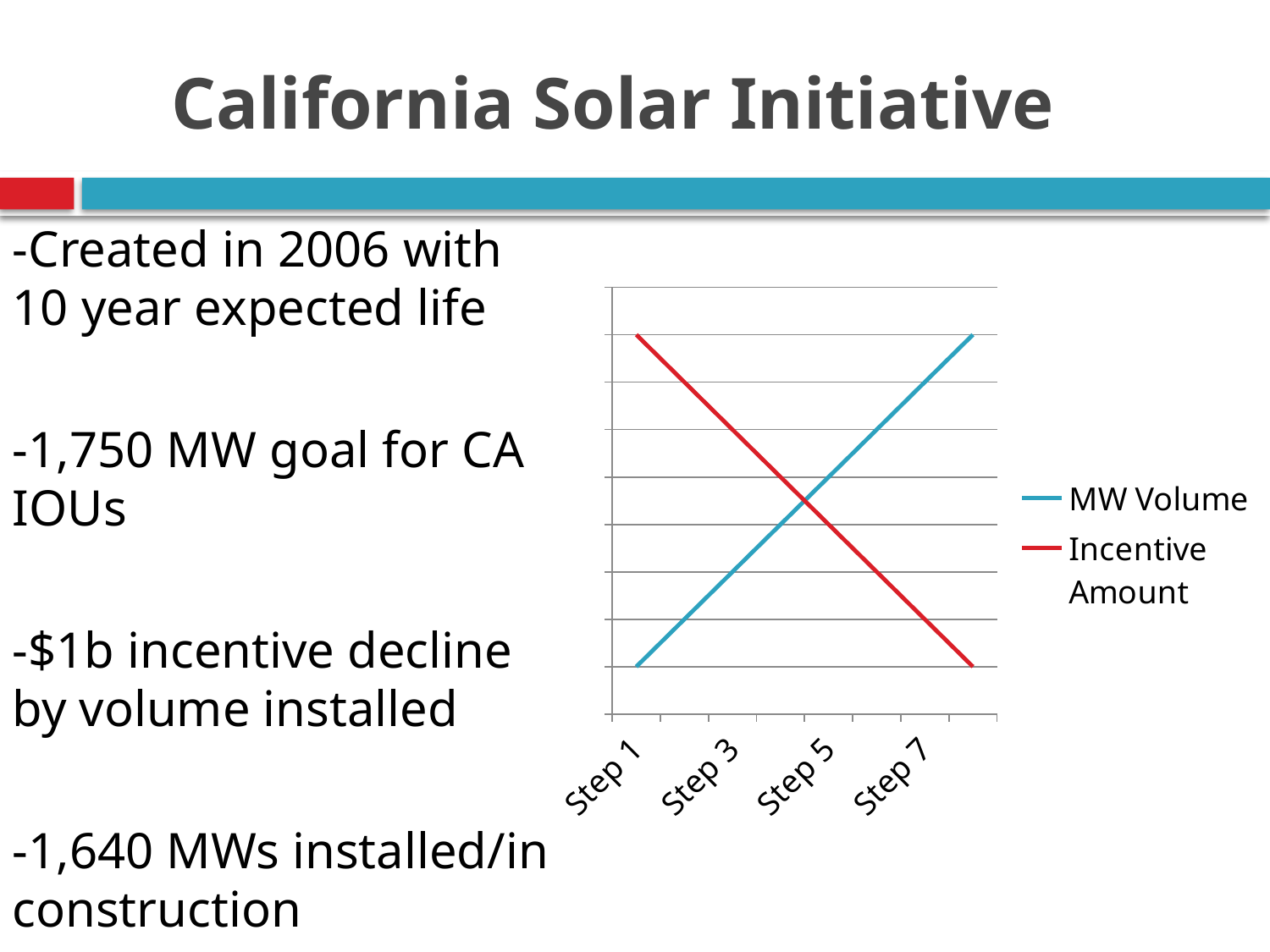
Which step label appears first on the x axis of the chart? Step 1 How many series does the chart's legend list? 2 How many step labels are printed along the x axis of the chart? 4 What are the two series named in the chart's legend? MW Volume and Incentive Amount What kind of chart is shown on the slide? Line chart At Step 1, which series has the higher value, MW Volume or Incentive Amount? Incentive Amount Which colour is used for the MW Volume line? Blue Does the Incentive Amount line rise or fall from Step 1 to Step 7? Fall At Step 7, which series has the higher value, MW Volume or Incentive Amount? MW Volume Does the MW Volume line rise or fall from Step 1 to Step 7? Rise